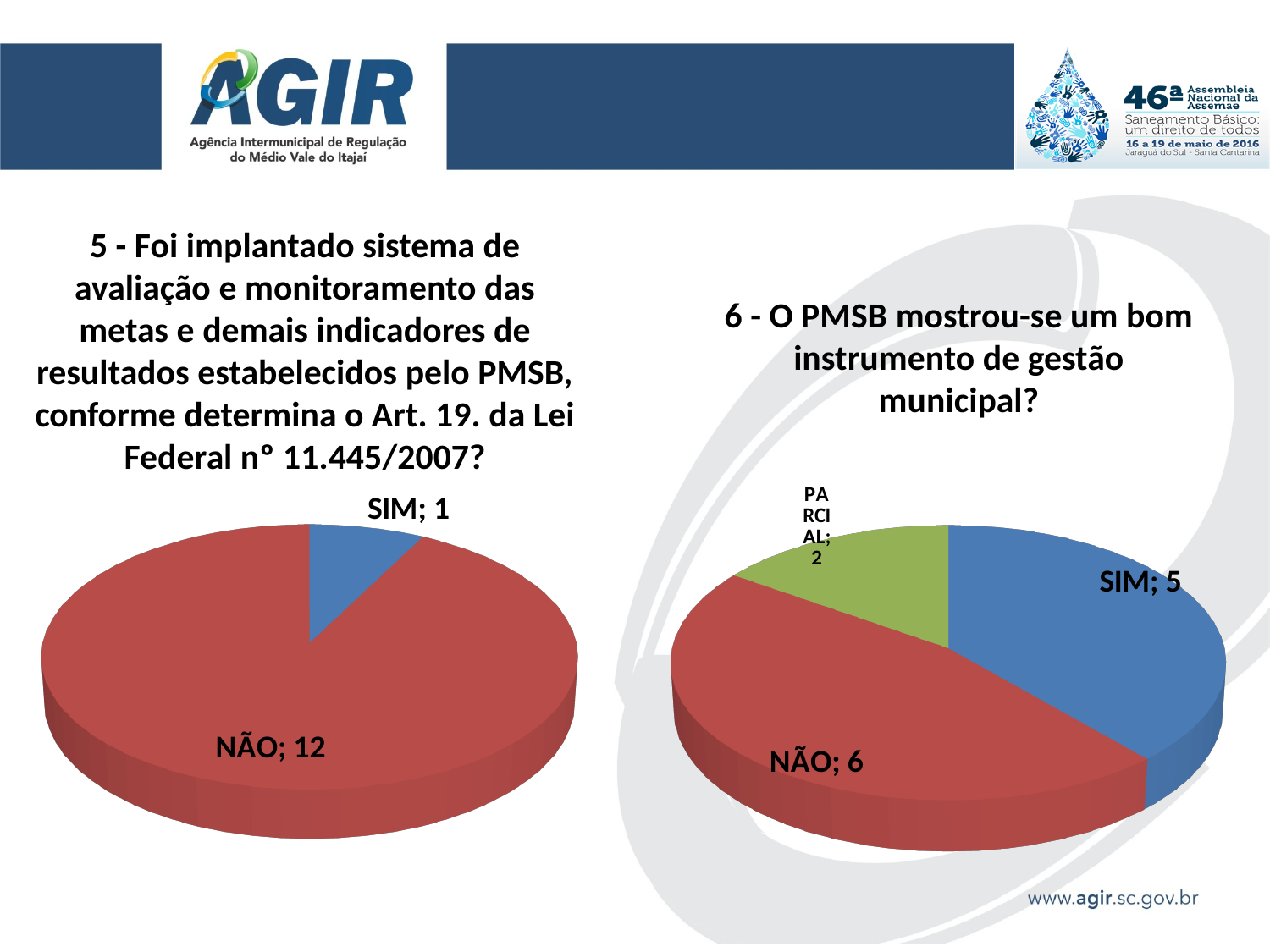
In the right pie chart (question 6), what is the value for SIM? 5 In the left pie chart (question 5), what is the difference between the NÃO and SIM values? 11 What type of chart is used on the left side of the slide? Pie chart In the right pie chart (question 6), which category has the smallest slice? PARCIAL In the left pie chart (question 5), how many slices are there? 2 In the right pie chart (question 6), what is the value for PARCIAL? 2 In the left pie chart (question 5), which category has the largest slice? NÃO In the right pie chart (question 6), what is the total of all slices? 13 In the left pie chart (question 5), what is the value for NÃO? 12 In the left pie chart (question 5), what is the value for SIM? 1 In the right pie chart (question 6), how many categories are shown? 3 In the right pie chart (question 6), which is larger, NÃO or SIM? NÃO